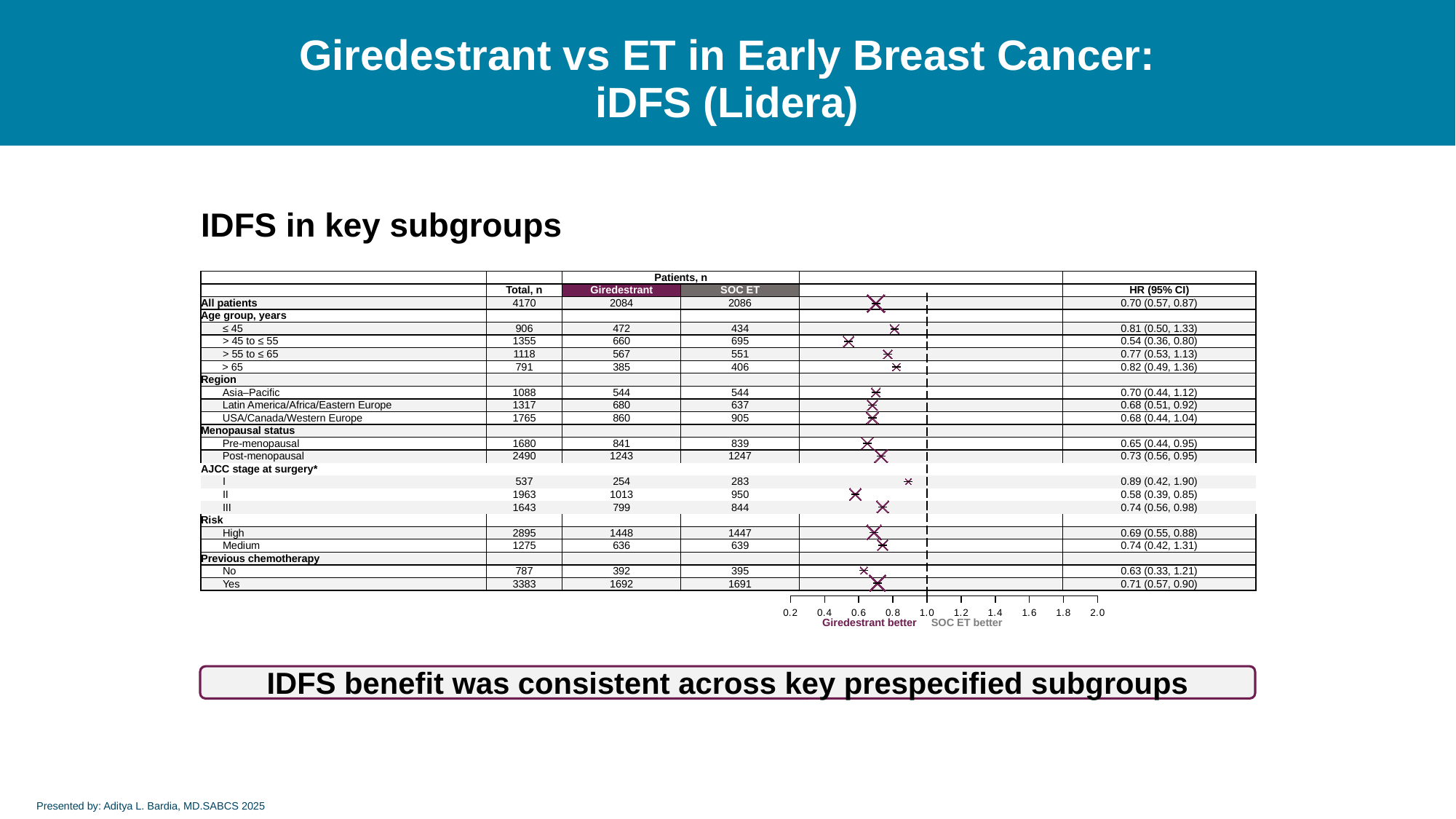
What is the difference between the hazard ratio point estimates for AJCC stage I and stage II? 0.31 What label appears under the left side of the x axis of the forest plot? Giredestrant better How many hazard ratio point estimates are plotted in the forest plot, including all patients? 17 What kind of chart is shown on the slide? Forest plot Is the hazard ratio point estimate for the high-risk subgroup greater or less than 1.0? less What is the hazard ratio (95% CI) for all patients? 0.70 (0.57, 0.87) Which subgroup has the highest hazard ratio point estimate? AJCC stage I What is the hazard ratio (95% CI) for AJCC stage I at surgery? 0.89 (0.42, 1.90) What is the hazard ratio (95% CI) for patients with no previous chemotherapy? 0.63 (0.33, 1.21) What is the hazard ratio (95% CI) for the > 45 to ≤ 55 age group? 0.54 (0.36, 0.80) Which has the larger hazard ratio point estimate: pre-menopausal or post-menopausal patients? Post-menopausal Which subgroup has the lowest hazard ratio point estimate? > 45 to ≤ 55 years